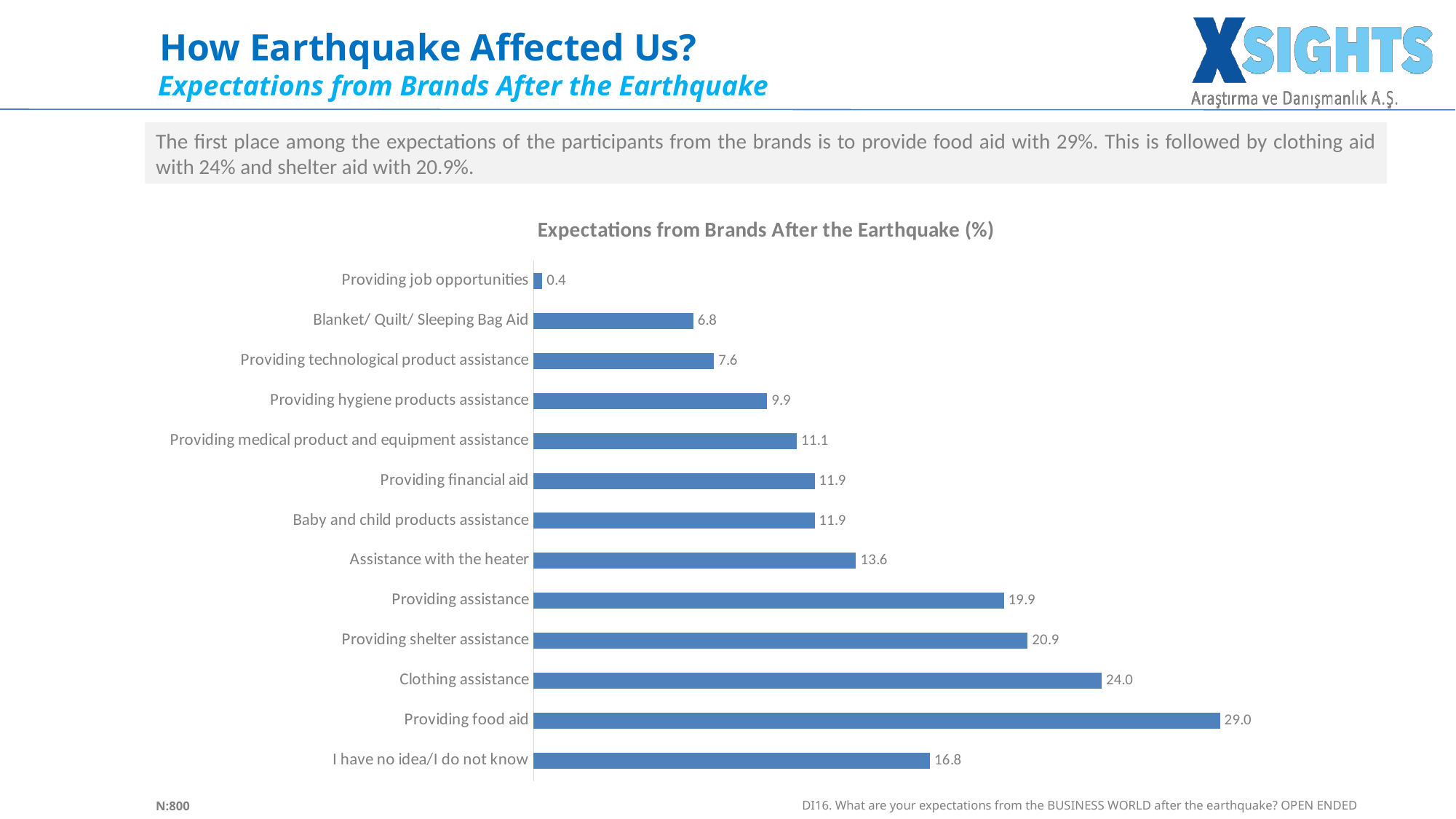
What is the value for Blanket/ Quilt/ Sleeping Bag Aid? 6.8 Which is larger, Providing assistance or Assistance with the heater? Providing assistance What is the title of the chart? Expectations from Brands After the Earthquake (%) Which category has the highest value? Providing food aid Which category has the lowest value? Providing job opportunities What is the value for Assistance with the heater? 13.6 What kind of chart is shown on the slide? Bar chart What is the value for Providing food aid? 29.0 How many categories are shown in the chart? 13 What is the difference between Providing food aid and I have no idea/I do not know? 12.2 Which is larger, Providing hygiene products assistance or Providing technological product assistance? Providing hygiene products assistance What is the difference between Clothing assistance and Providing shelter assistance? 3.1